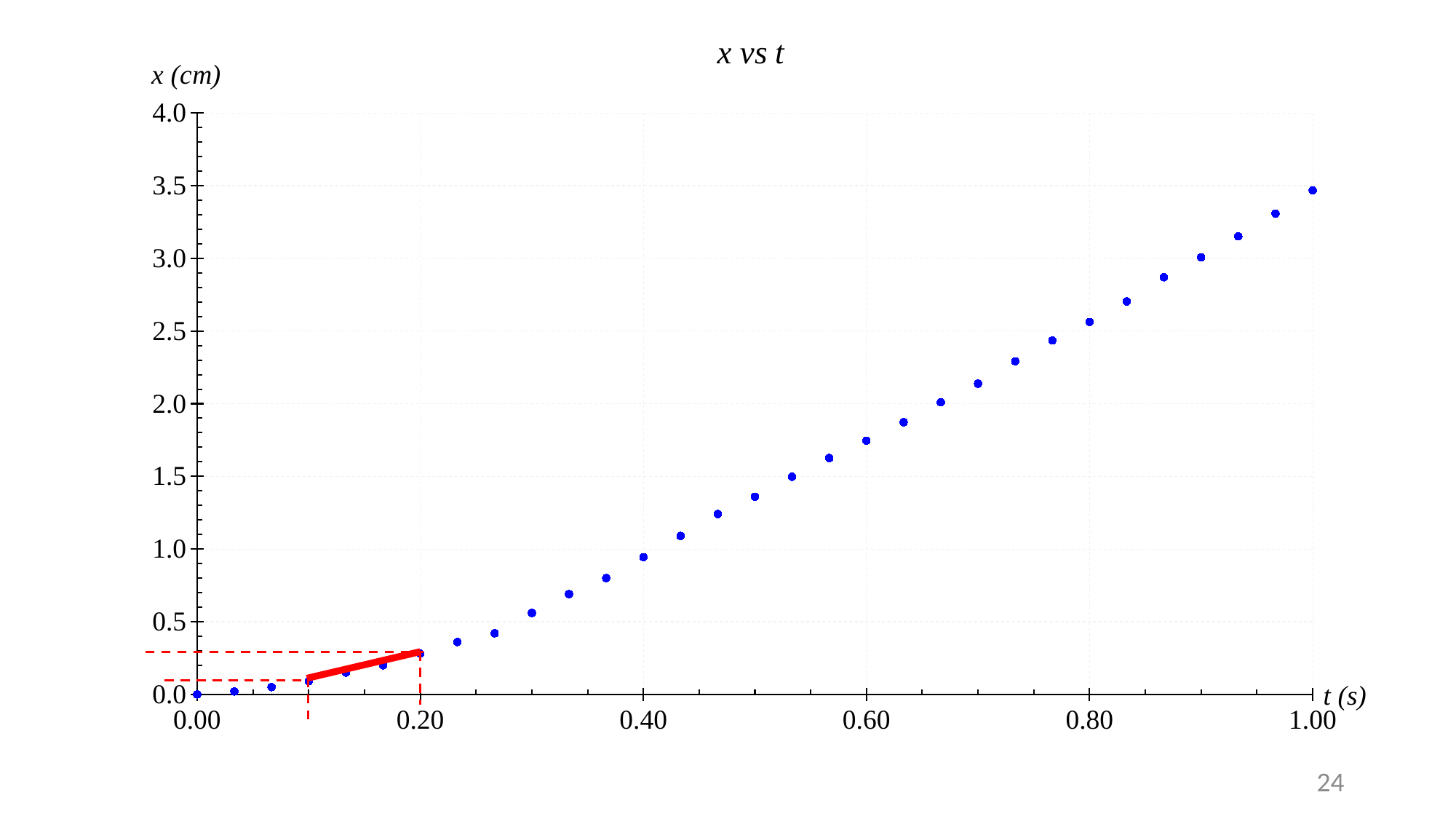
Is the value of x at t = 1.00 greater or less than 3.0? greater Is the value of x at t = 0.60 greater or less than 2.0? less What is the title of the chart? x vs t What kind of chart is shown on the slide? scatter chart Do the plotted x values rise or fall as t increases? rise Is the value of x at t = 0.80 greater or less than 2.0? greater Which has the larger x value, t = 0.80 or t = 0.40? t = 0.80 At which value of t is x lowest? 0.00 What is the label of the horizontal axis? t (s) At which value of t is x highest? 1.00